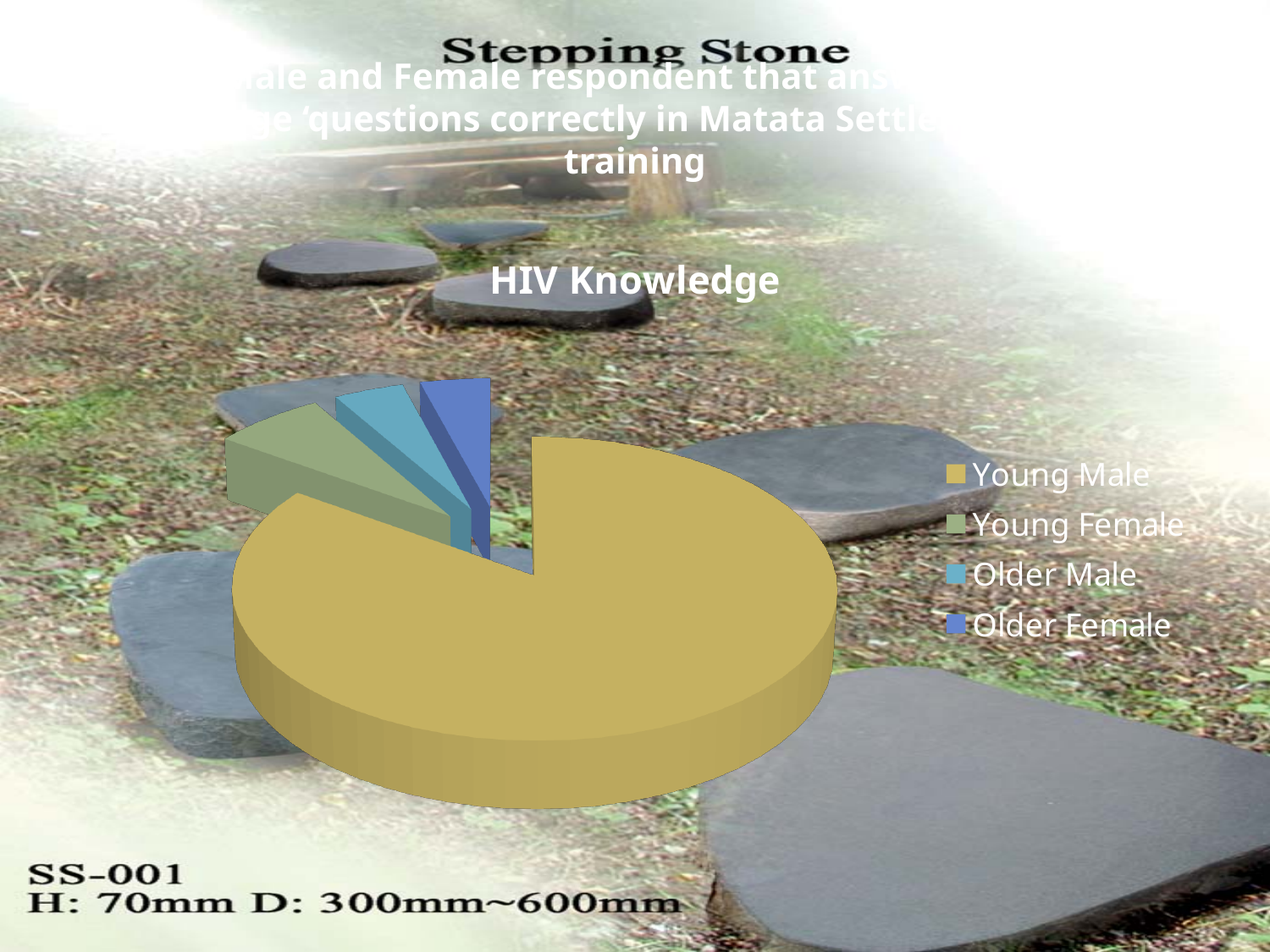
Which slice is larger, Young Male or Young Female? Young Male Which category is shown in the gold/yellow colour in the pie chart? Young Male Does the Young Male slice take up more or less than half of the pie? More How many categories does the pie chart's legend list? 4 What kind of chart is shown on the slide? Pie chart Which slice is larger, Young Female or Older Male? Young Female What is the title of the chart? HIV Knowledge Which category has the largest slice of the pie? Young Male